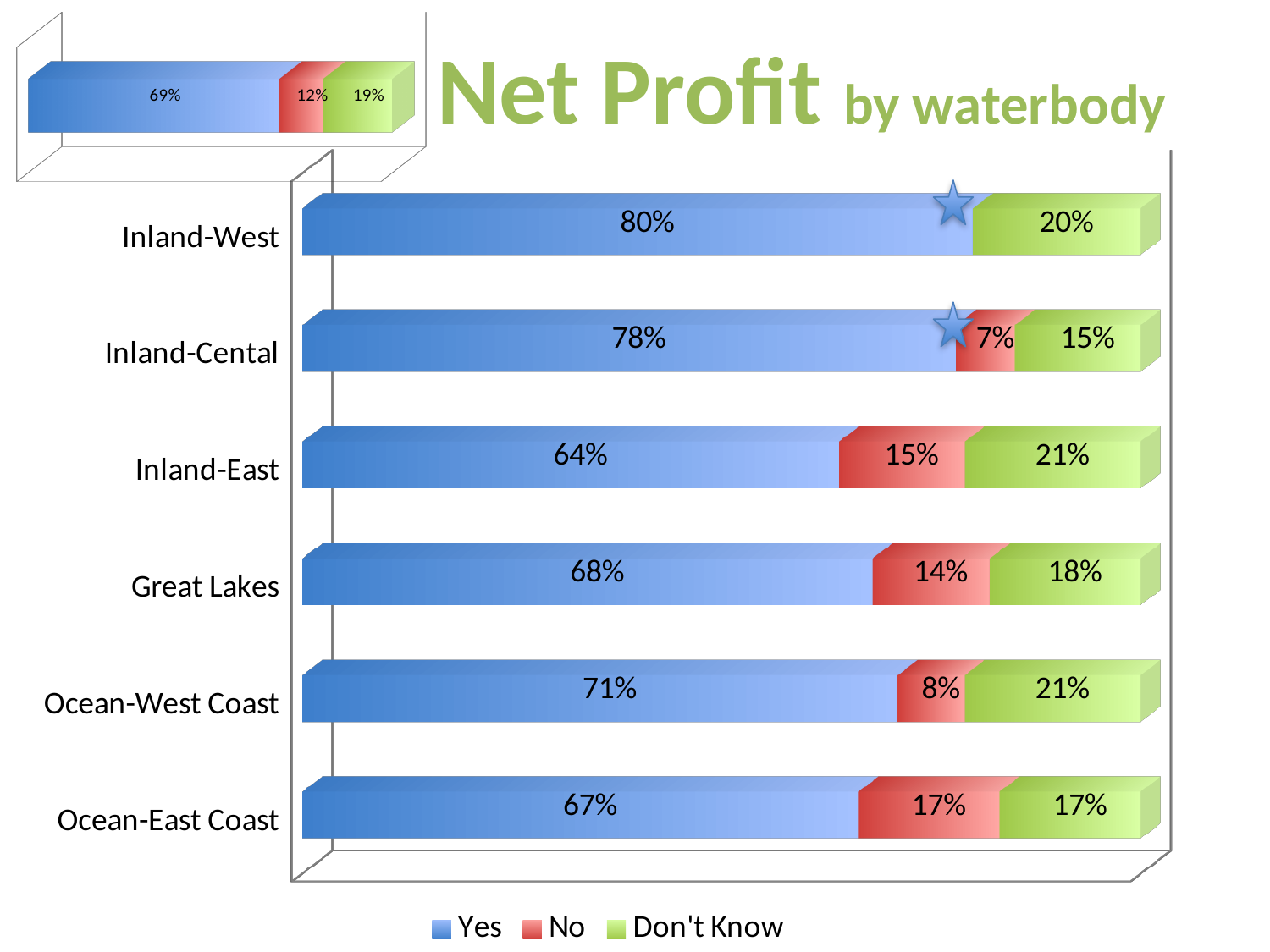
How many series does the legend of the Net Profit by waterbody chart list? 3 In the Net Profit by waterbody chart, what is the No value for Ocean-East Coast? 17% In the Net Profit by waterbody chart, which waterbody has the highest Yes value? Inland-West In the Net Profit by waterbody chart, which waterbody has the lowest Yes value? Inland-East In the Net Profit by waterbody chart, what is the difference between the Yes values for Inland-West and Inland-East? 16% In the small chart at the top left of the slide, what is the value of the blue segment? 69% In the Net Profit by waterbody chart, which is larger, the No value for Inland-East or the No value for Ocean-West Coast? Inland-East In the Net Profit by waterbody chart, what is the Don't Know value for Great Lakes? 18% How many waterbody categories are shown in the Net Profit by waterbody chart? 6 In the Net Profit by waterbody chart, which legend entry is shown in green? Don't Know In the Net Profit by waterbody chart, what is the Yes value for Inland-West? 80% What kind of chart is the Net Profit by waterbody chart? Stacked bar chart